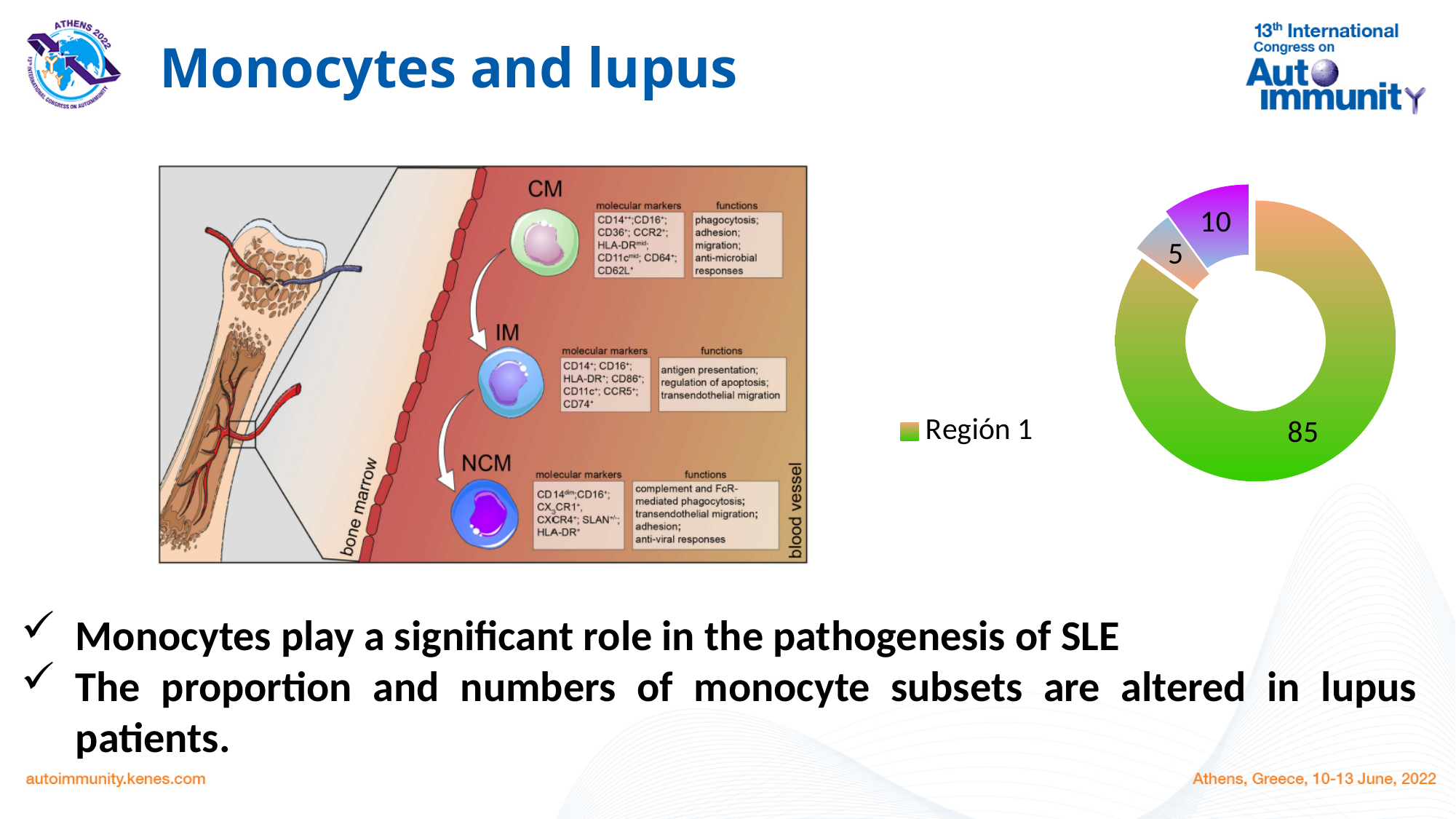
What is the difference between the largest slice (85) and the smallest slice (5) in the doughnut chart? 80 What is the value of the smallest slice in the doughnut chart? 5 What is the difference between the slice labelled 10 and the slice labelled 5 in the doughnut chart? 5 How many entries does the legend of the doughnut chart list? 1 What is the total of all slice values in the doughnut chart? 100 How many slices does the doughnut chart have? 3 Which is larger in the doughnut chart, the purple slice or the grey slice? the purple slice What share of the doughnut chart does the slice labelled 85 represent? 85% What is the value of the largest slice in the doughnut chart? 85 What is the legend entry shown next to the doughnut chart? Región 1 What kind of chart is shown on the right side of the slide? doughnut chart What is the value of the purple slice in the doughnut chart? 10